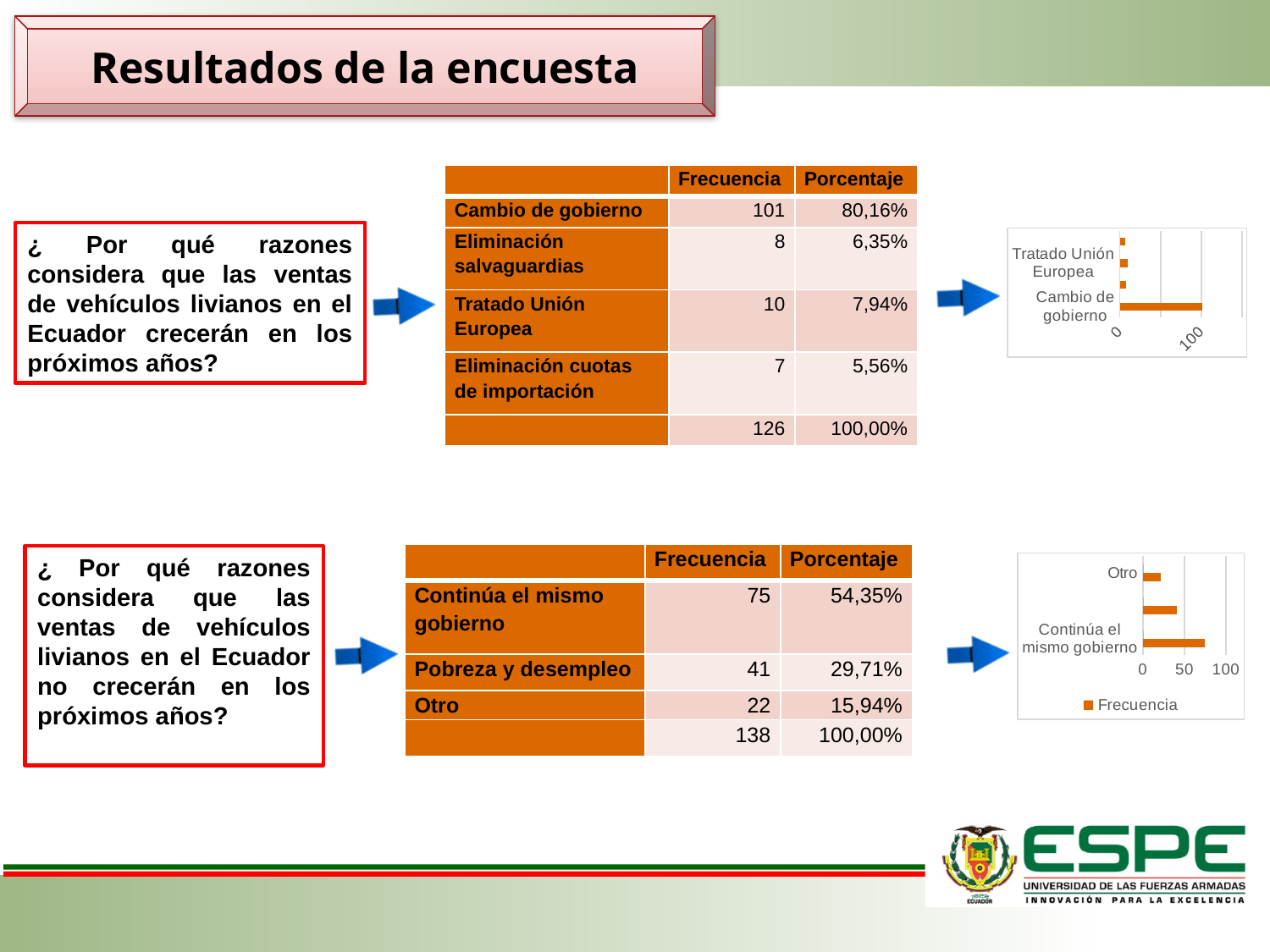
In the bottom-right chart, is the value for Otro greater or less than 50? less In the bottom-right chart, is the value for Continúa el mismo gobierno greater or less than 50? greater In the top-right chart, which category has the longest bar? Cambio de gobierno In the top-right chart, is the value for Cambio de gobierno greater or less than 50? greater How many series does the legend of the bottom-right chart list? 1 According to the table next to the top-right chart, what is the Frecuencia for Cambio de gobierno? 101 What is the legend entry shown in the bottom-right chart? Frecuencia What kind of chart is the chart at the top right of the slide? bar chart In the top-right chart, which is larger, Cambio de gobierno or Tratado Unión Europea? Cambio de gobierno In the bottom-right chart, how many bars are plotted? 3 In the top-right chart, how many bars are plotted? 4